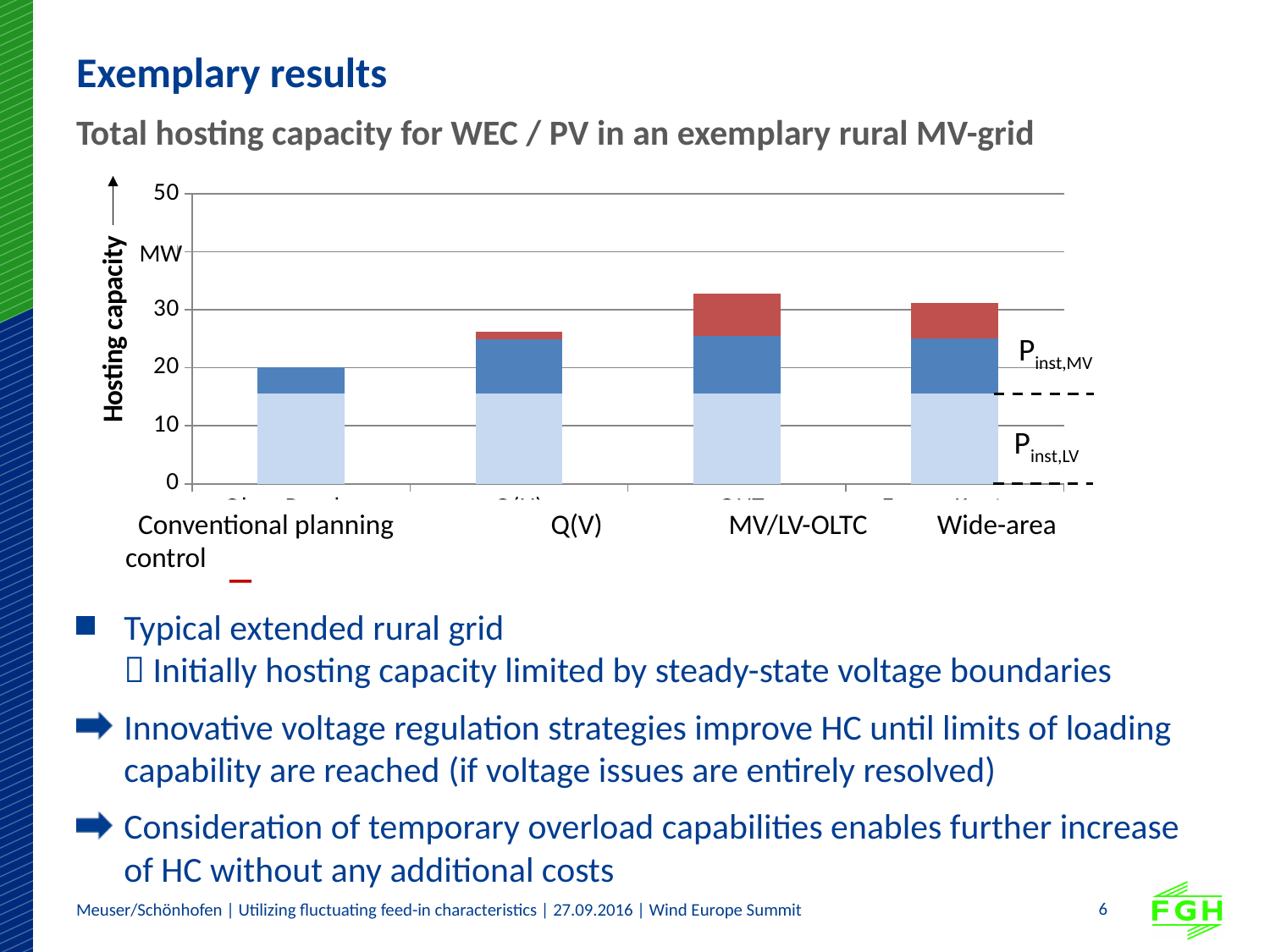
Is the total hosting capacity for MV/LV-OLTC greater or less than 30 MW? greater Which has a larger total hosting capacity, Q(V) or MV/LV-OLTC? MV/LV-OLTC What unit is shown on the vertical axis of the chart? MW What kind of chart is shown on the slide? stacked bar chart How many categories are shown on the x axis of the chart? 4 Is the total hosting capacity for Conventional planning greater or less than 30 MW? less Is the total hosting capacity for Wide-area control greater or less than 20 MW? greater Which category has the highest total hosting capacity? MV/LV-OLTC Which has a larger total hosting capacity, Conventional planning or Wide-area control? Wide-area control What is the label of the vertical axis of the chart? Hosting capacity Which category has the lowest total hosting capacity? Conventional planning